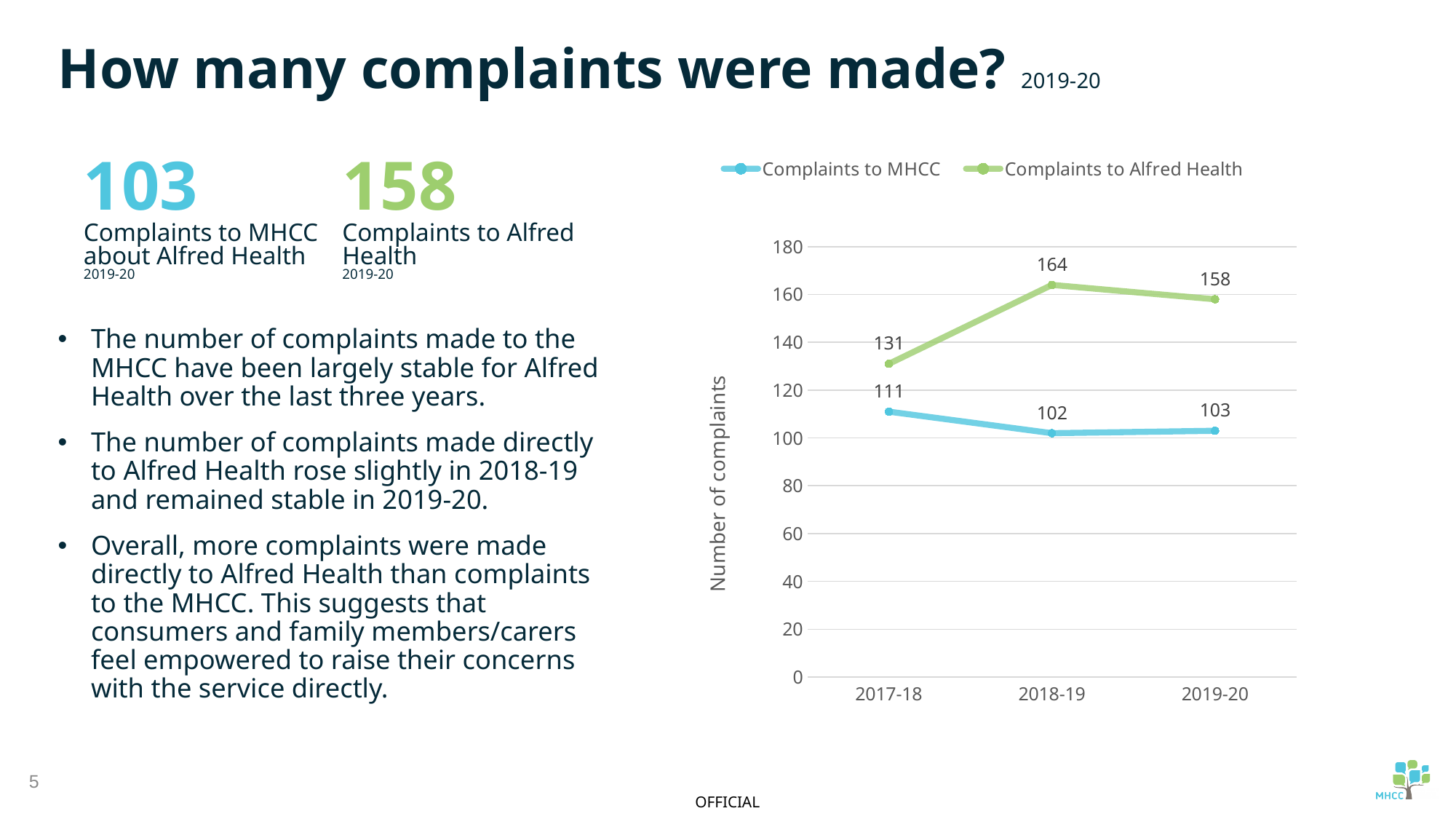
What is the difference between complaints to Alfred Health and complaints to MHCC in 2019-20? 55 How many series does the chart legend list? 2 Did complaints to Alfred Health rise or fall from 2017-18 to 2018-19? Rise How many complaints were made to Alfred Health in 2018-19? 164 What is the label of the chart's y axis? Number of complaints How many complaints were made to MHCC in 2017-18? 111 How many complaints were made to Alfred Health in 2019-20? 158 Which series had more complaints in 2017-18, Complaints to MHCC or Complaints to Alfred Health? Complaints to Alfred Health What type of chart is shown on the slide? Line chart In which year were complaints to MHCC lowest? 2018-19 How many years are shown on the x axis of the chart? 3 In which year were complaints to Alfred Health highest? 2018-19